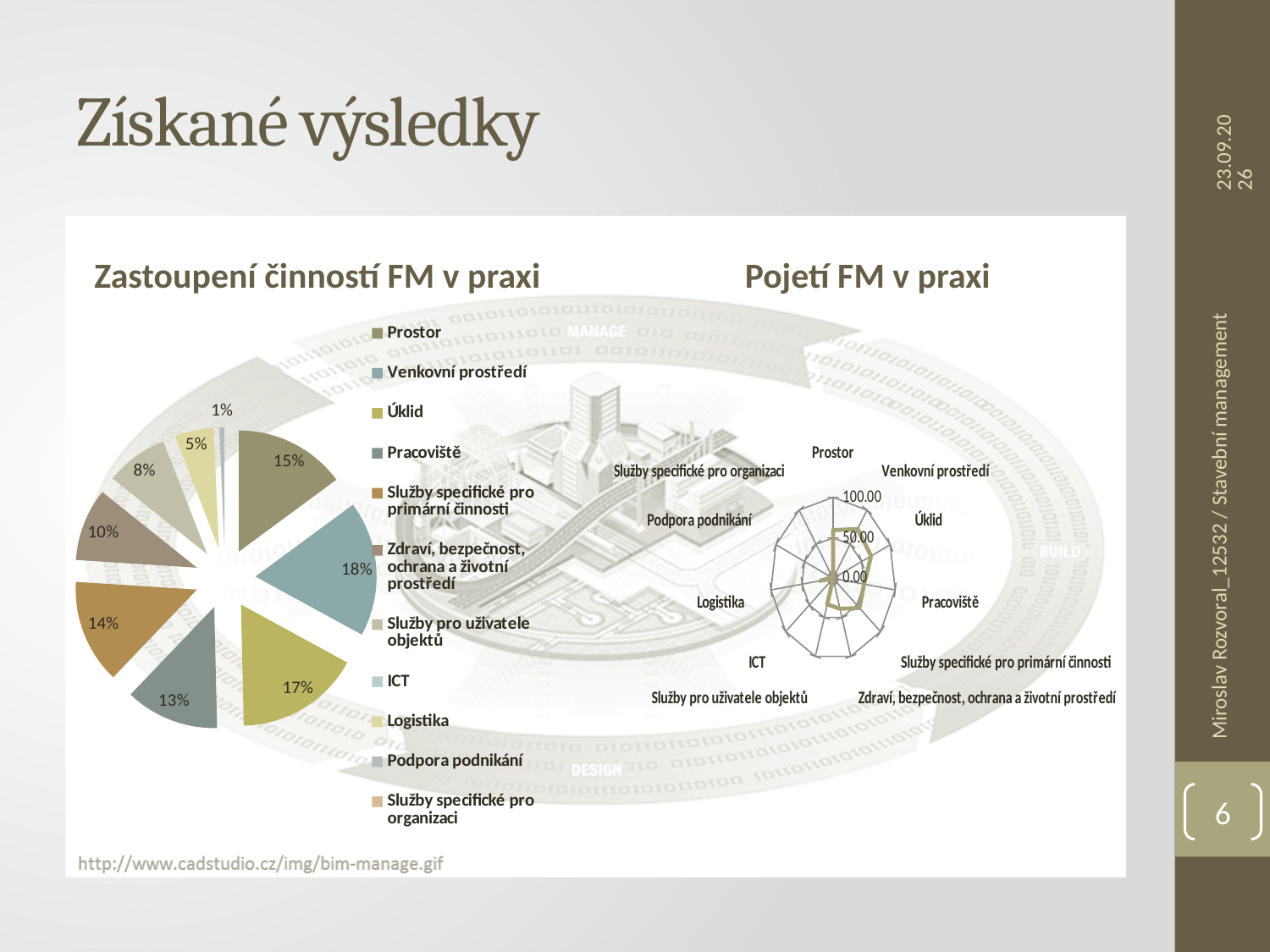
In the radar chart "Pojetí FM v praxi", is the value for Logistika greater or less than 50.00? less How many entries does the legend of the pie chart "Zastoupení činností FM v praxi" list? 11 In the pie chart "Zastoupení činností FM v praxi", which is larger: Úklid or Pracoviště? Úklid In the pie chart "Zastoupení činností FM v praxi", what is the difference between the shares of Venkovní prostředí and Prostor? 3% How many categories (axes) does the radar chart "Pojetí FM v praxi" have? 11 In the pie chart "Zastoupení činností FM v praxi", what share does Venkovní prostředí have? 18% What type of chart is "Zastoupení činností FM v praxi"? pie chart What type of chart is "Pojetí FM v praxi"? radar chart In the pie chart "Zastoupení činností FM v praxi", what share does Úklid have? 17% In the pie chart "Zastoupení činností FM v praxi", what share does Prostor have? 15% In the pie chart "Zastoupení činností FM v praxi", which category has the largest share? Venkovní prostředí In the pie chart "Zastoupení činností FM v praxi", what share does Pracoviště have? 13%